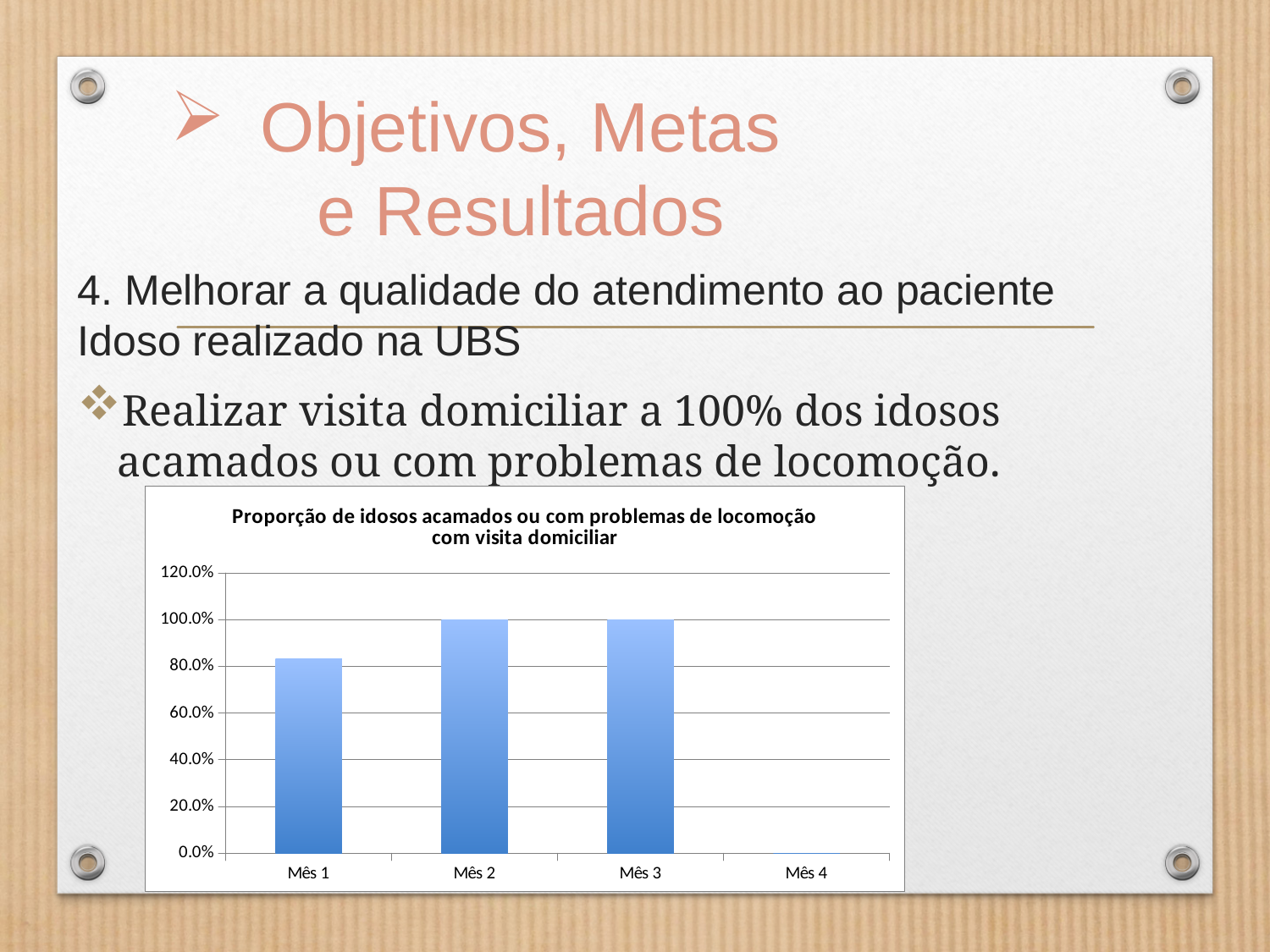
What kind of chart is shown on the slide? bar chart What is the value for Mês 2? 100.0% Which is larger, the value for Mês 1 or the value for Mês 2? Mês 2 Is the value for Mês 1 greater or less than 60.0%? greater How many categories (months) are shown on the x axis of the chart? 4 What is the value for Mês 4? 0.0% What is the title of the chart? Proporção de idosos acamados ou com problemas de locomoção com visita domiciliar Does the value rise or fall from Mês 3 to Mês 4? fall What is the value for Mês 3? 100.0% What is the difference between the values for Mês 3 and Mês 4? 100.0% Is the value for Mês 1 greater or less than 100.0%? less Which month has the lowest value? Mês 4